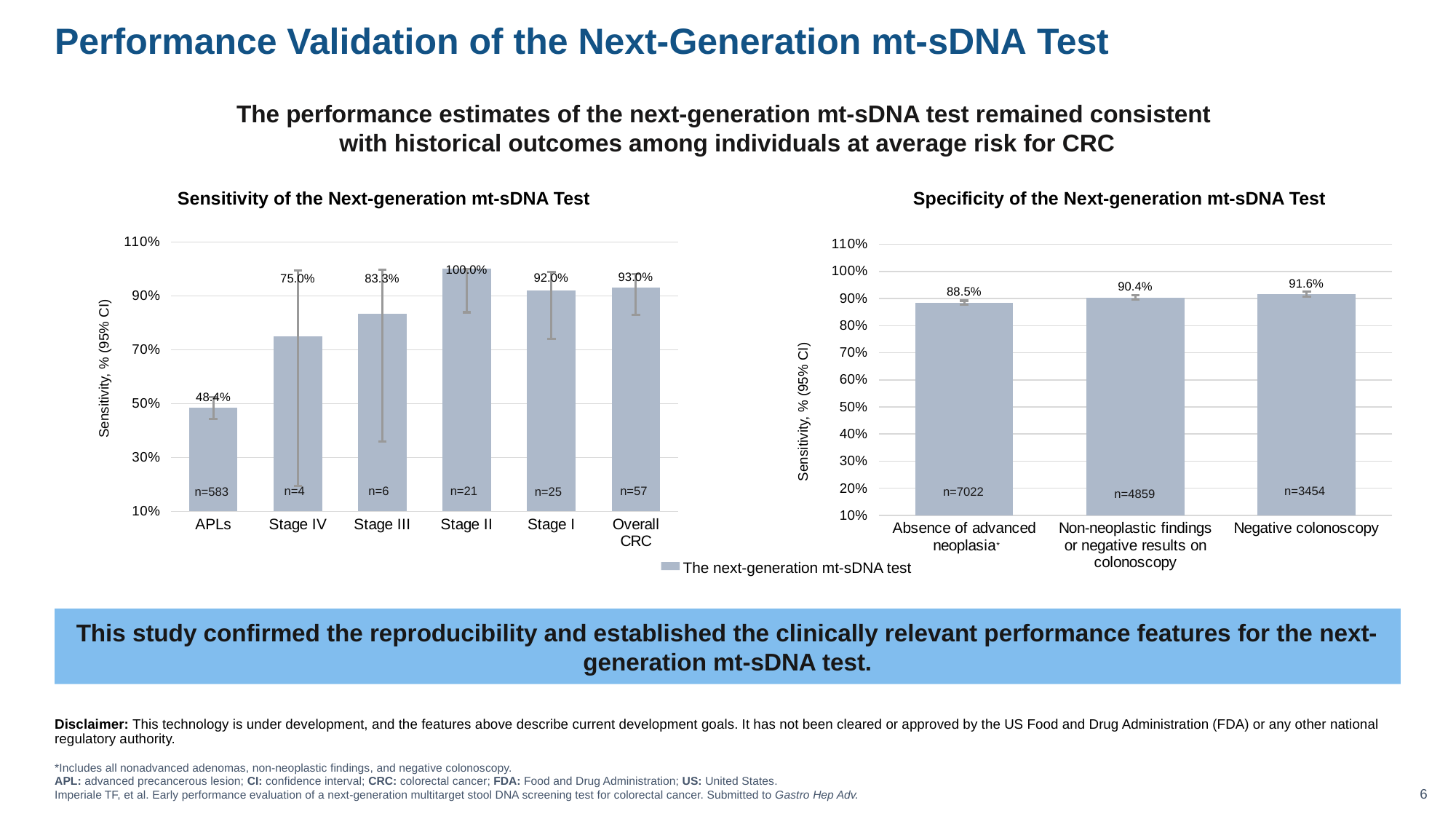
In the Specificity of the Next-generation mt-sDNA Test chart, what is the difference between the values for Negative colonoscopy and Absence of advanced neoplasia? 3.1% In the Specificity of the Next-generation mt-sDNA Test chart, how many categories are shown? 3 In the Sensitivity of the Next-generation mt-sDNA Test chart, how many categories are shown on the x axis? 6 In the Sensitivity of the Next-generation mt-sDNA Test chart, which category has the lowest sensitivity? APLs In the Specificity of the Next-generation mt-sDNA Test chart, which category has the lowest value? Absence of advanced neoplasia In the Specificity of the Next-generation mt-sDNA Test chart, what is the specificity for Negative colonoscopy? 91.6% In the Sensitivity of the Next-generation mt-sDNA Test chart, which category has the highest sensitivity? Stage II In the Sensitivity of the Next-generation mt-sDNA Test chart, what is the sensitivity for Stage II? 100.0% In the Sensitivity of the Next-generation mt-sDNA Test chart, what is the difference between the sensitivity for Overall CRC and for Stage IV? 18.0% What type of chart is the Sensitivity of the Next-generation mt-sDNA Test chart? Bar chart In the Sensitivity of the Next-generation mt-sDNA Test chart, what is the sample size (n) shown for Stage I? n=25 In the Sensitivity of the Next-generation mt-sDNA Test chart, what is the sensitivity for APLs? 48.4%